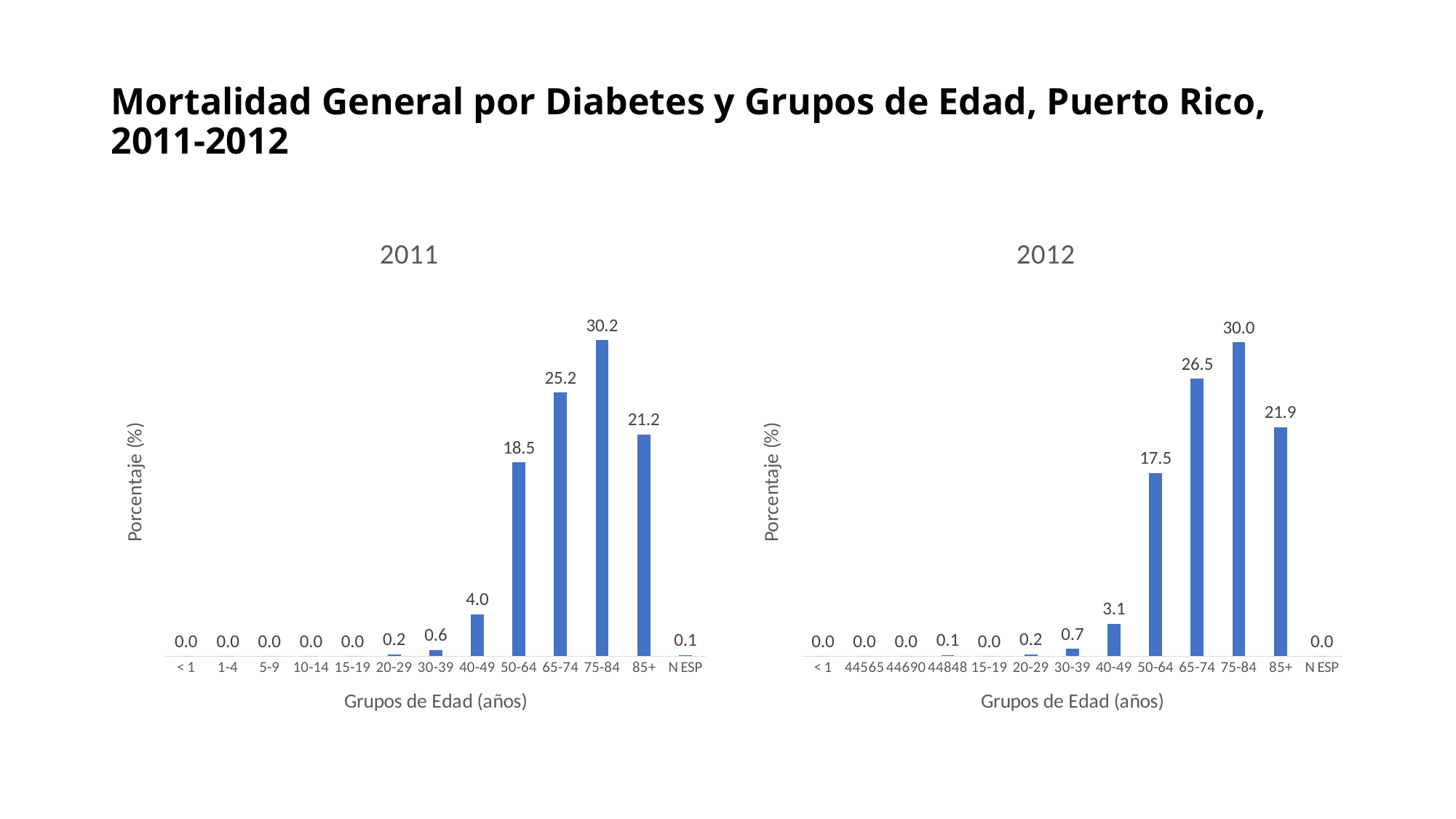
In the 2011 chart, what is the difference between the values for 75-84 and 50-64? 11.7 In the 2012 chart, what is the value for the 50-64 age group? 17.5 How many age group categories are shown on the x axis of the 2011 chart? 13 In the 2012 chart, which is larger, the value for 40-49 or the value for 30-39? 40-49 In the 2012 chart, which age group has the highest value? 75-84 What is the y-axis label of the 2011 chart? Porcentaje (%) In the 2012 chart, what is the difference between the values for 65-74 and 85+? 4.6 In the 2011 chart, what is the value for the 75-84 age group? 30.2 In the 2011 chart, which is larger, the value for 65-74 or the value for 85+? 65-74 What type of chart is the 2012 chart? Bar chart In the 2011 chart, what is the value for the 40-49 age group? 4.0 In the 2011 chart, which age group has the highest value? 75-84